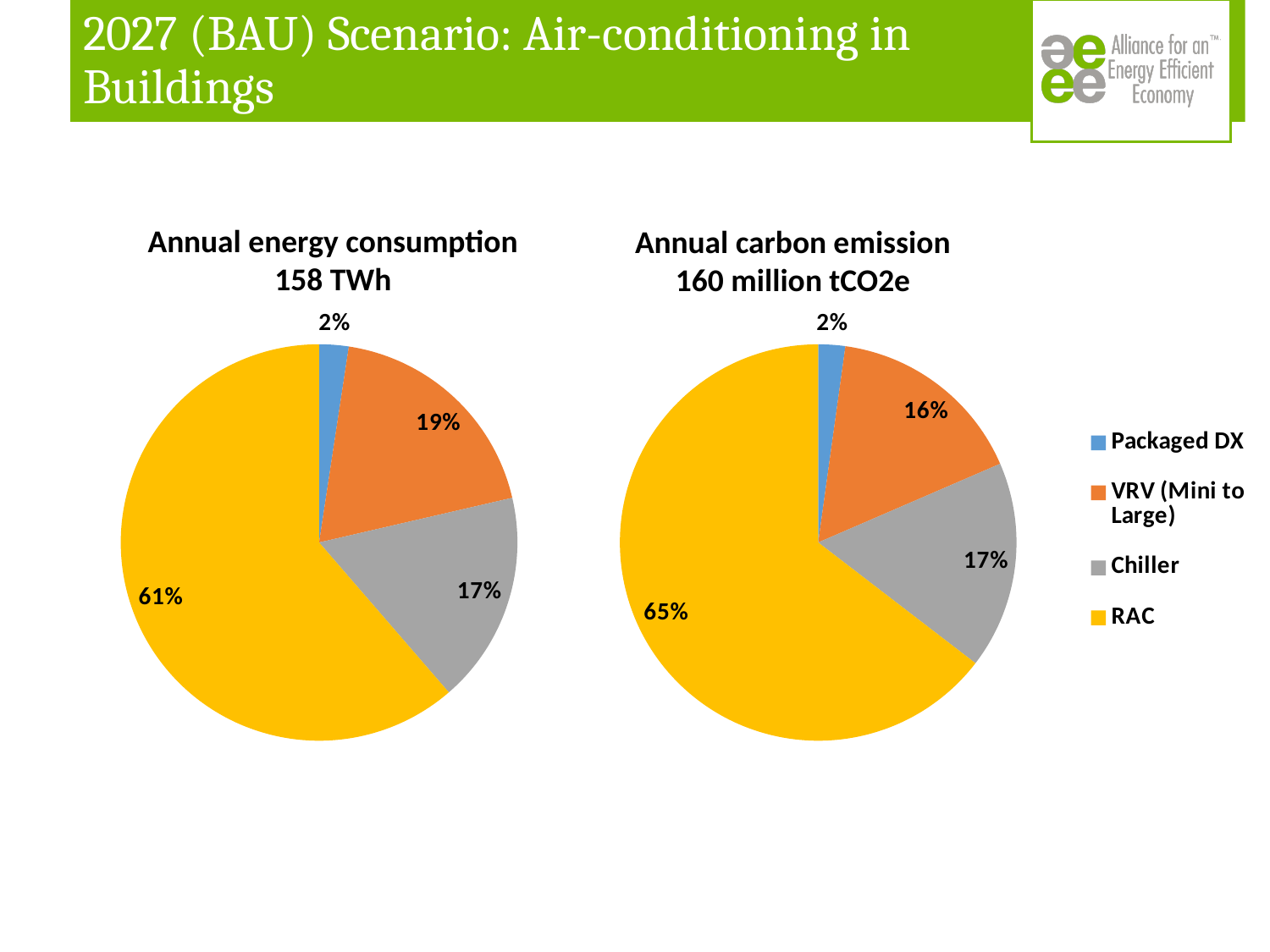
How many categories does the legend list for the pie charts? 4 In the 'Annual energy consumption 158 TWh' pie chart, which category has the largest share? RAC In the 'Annual carbon emission 160 million tCO2e' pie chart, what share does Packaged DX have? 2% Which colour represents Chiller in the pie charts? Grey In the 'Annual carbon emission 160 million tCO2e' pie chart, what share does RAC have? 65% In the 'Annual carbon emission 160 million tCO2e' pie chart, which category has the smallest share? Packaged DX In the 'Annual energy consumption 158 TWh' pie chart, which is larger, the VRV (Mini to Large) share or the Chiller share? VRV (Mini to Large) In the 'Annual carbon emission 160 million tCO2e' pie chart, what share does Chiller have? 17% In the 'Annual energy consumption 158 TWh' pie chart, what is the difference between the RAC share and the Chiller share? 44% What type of chart is used for 'Annual carbon emission 160 million tCO2e'? Pie chart